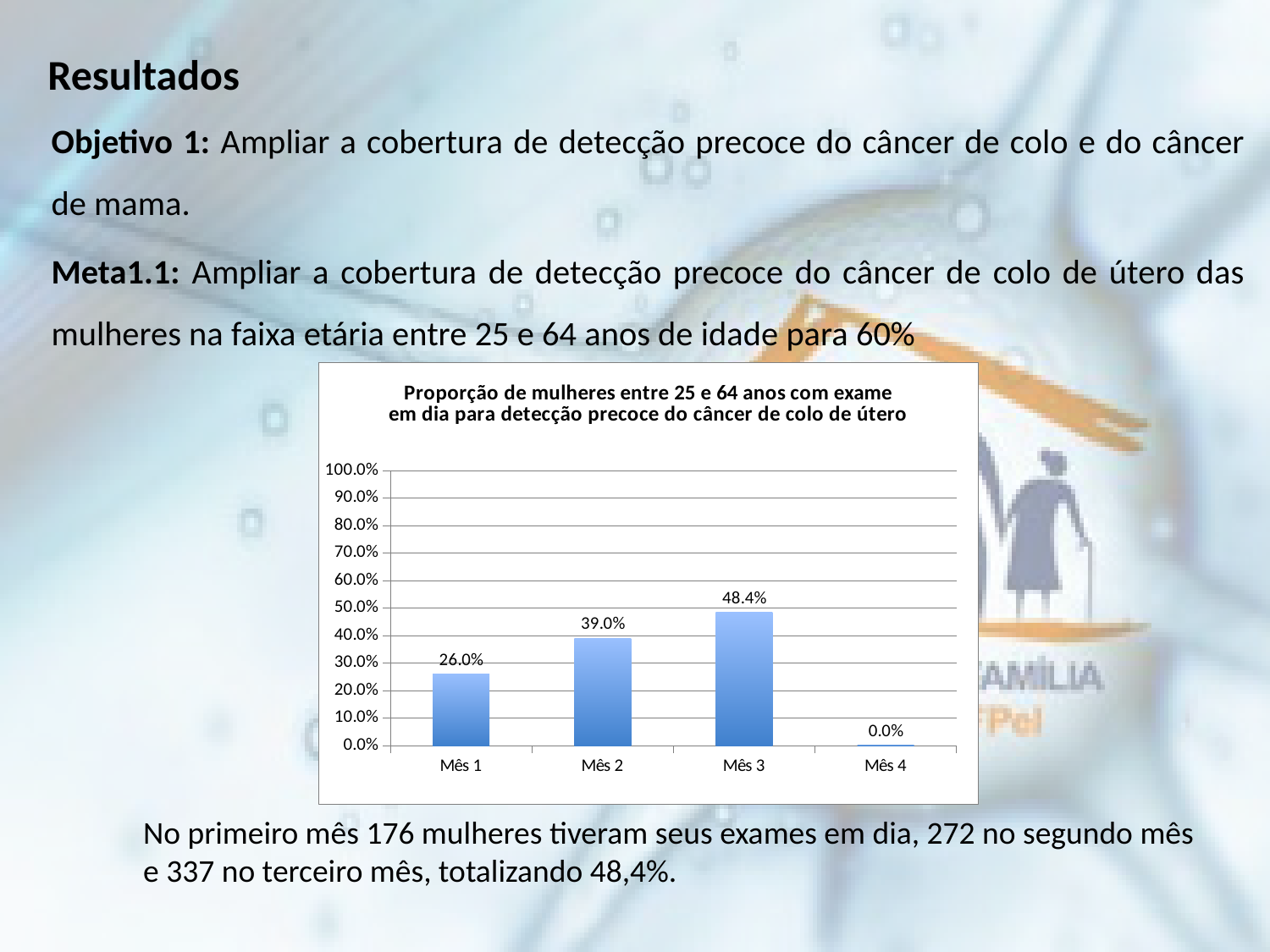
What is the value for Mês 4? 0.0% What is the title of the chart? Proporção de mulheres entre 25 e 64 anos com exame em dia para detecção precoce do câncer de colo de útero Is the value for Mês 3 greater or less than 50.0%? less What is the difference between the values for Mês 3 and Mês 1? 22.4% How many months are shown on the x axis? 4 What is the value for Mês 2? 39.0% What is the value for Mês 3? 48.4% What kind of chart is shown? bar chart What is the value for Mês 1? 26.0% Which month has the highest value? Mês 3 Which is larger, the value for Mês 2 or the value for Mês 1? Mês 2 Which month has the lowest value? Mês 4